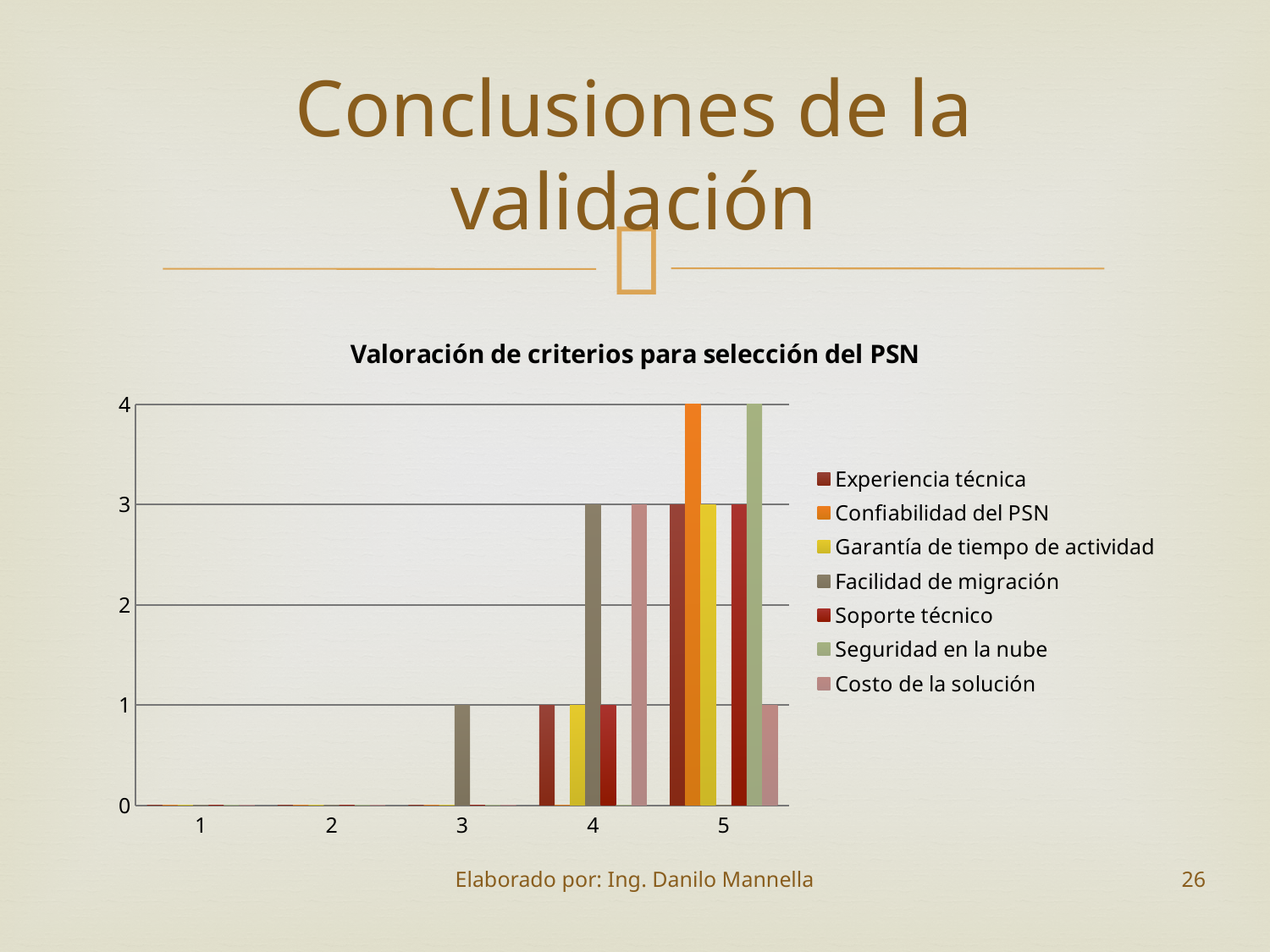
Which is larger at category 5: Confiabilidad del PSN or Experiencia técnica? Confiabilidad del PSN How many categories are shown on the x axis of the chart? 5 What is the value for Confiabilidad del PSN at category 5? 4 How many series does the chart legend list? 7 What kind of chart is shown on the slide? bar chart What is the value for Facilidad de migración at category 3? 1 What is the value for Costo de la solución at category 5? 1 What is the title of the chart? Valoración de criterios para selección del PSN Which series has the highest value at category 4? Facilidad de migración and Costo de la solución What is the difference between Seguridad en la nube and Costo de la solución at category 5? 3 What is the value for Facilidad de migración at category 4? 3 Which series is shown in yellow in the legend? Garantía de tiempo de actividad